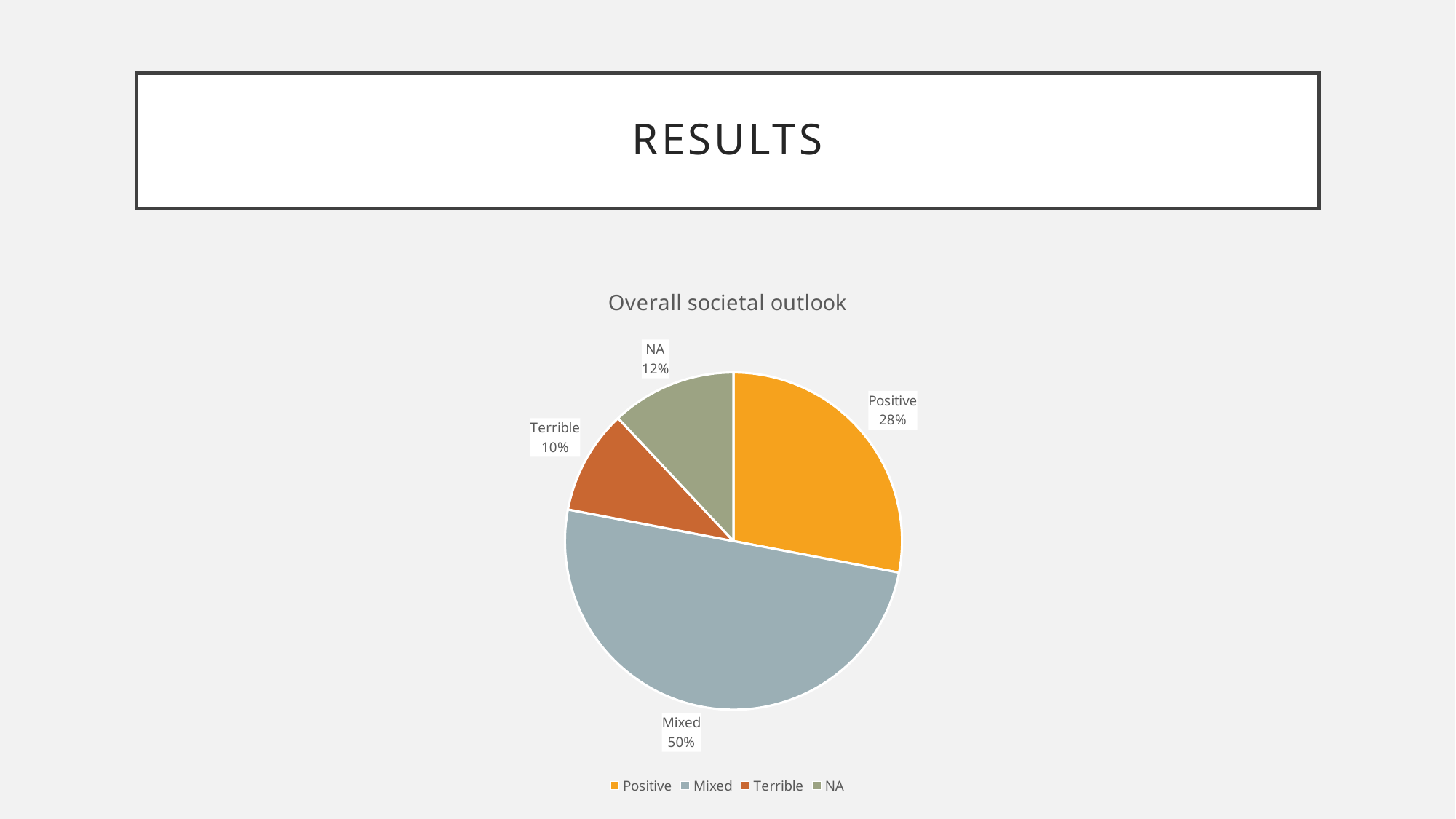
What is the value shown for Terrible? 10% How many categories are shown in the pie chart? 4 What is the value shown for Positive? 28% Which is larger, the Positive slice or the NA slice? Positive What colour is the Mixed slice? grey-blue What is the title of the chart? Overall societal outlook What kind of chart is shown on the slide? pie chart What share of the pie does the Mixed slice represent? 50% What is the value shown for NA? 12% Which category has the largest slice of the pie? Mixed Which category has the smallest slice of the pie? Terrible What is the difference in percentage points between Mixed and Positive? 22